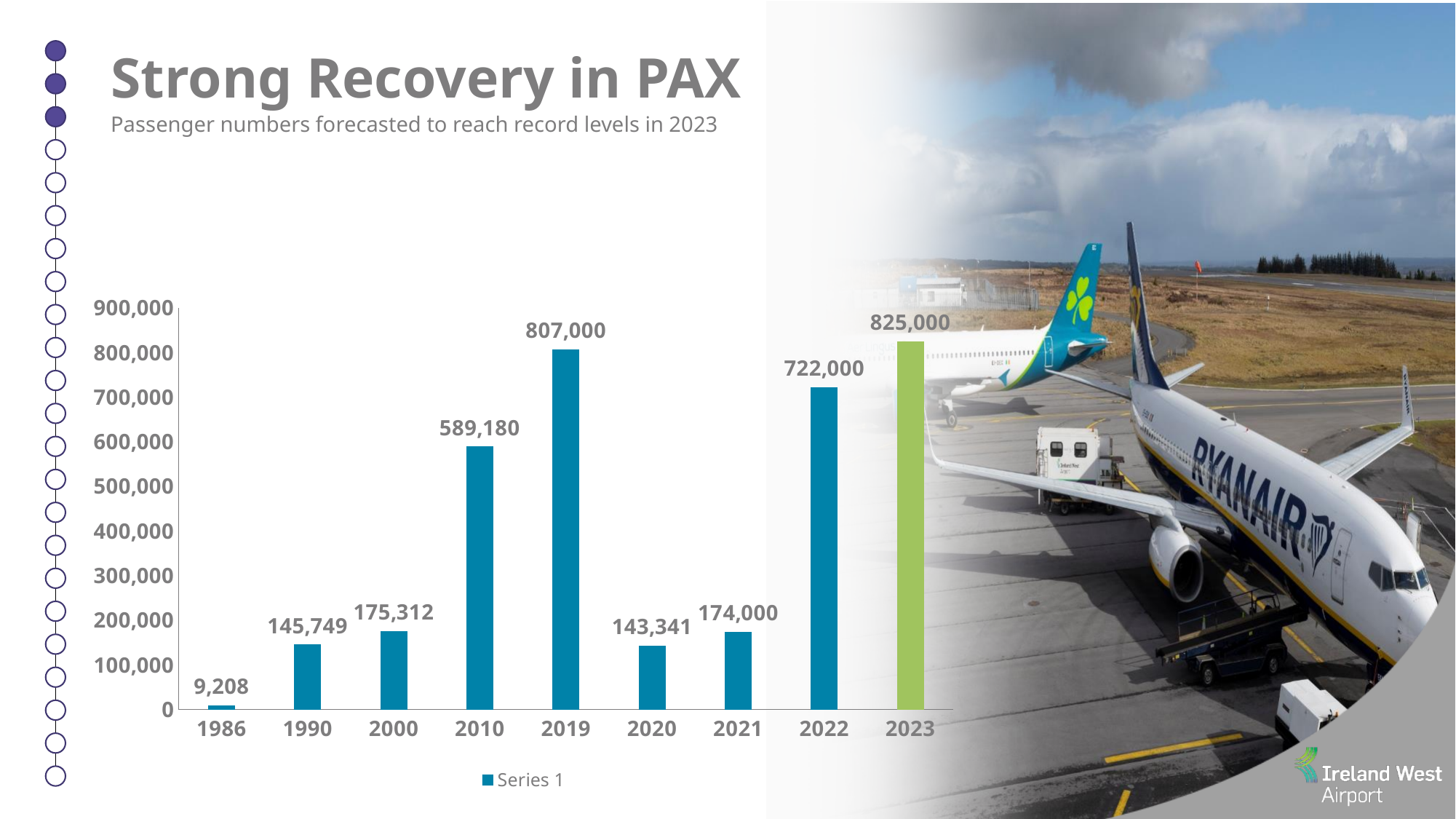
What is the difference between the passenger numbers for 2023 and 2022? 103,000 How many series does the legend list? 1 What is the title of the slide? Strong Recovery in PAX What is the passenger number shown for 2010? 589,180 What is the passenger number shown for 2019? 807,000 Is the value for 2020 greater or less than 200,000? less Which year has the larger passenger number, 2000 or 2021? 2000 Which year has the highest passenger number? 2023 How many years are shown on the x axis? 9 Which year has the lowest passenger number? 1986 What kind of chart is shown on the slide? bar chart What is the passenger number shown for 1986? 9,208